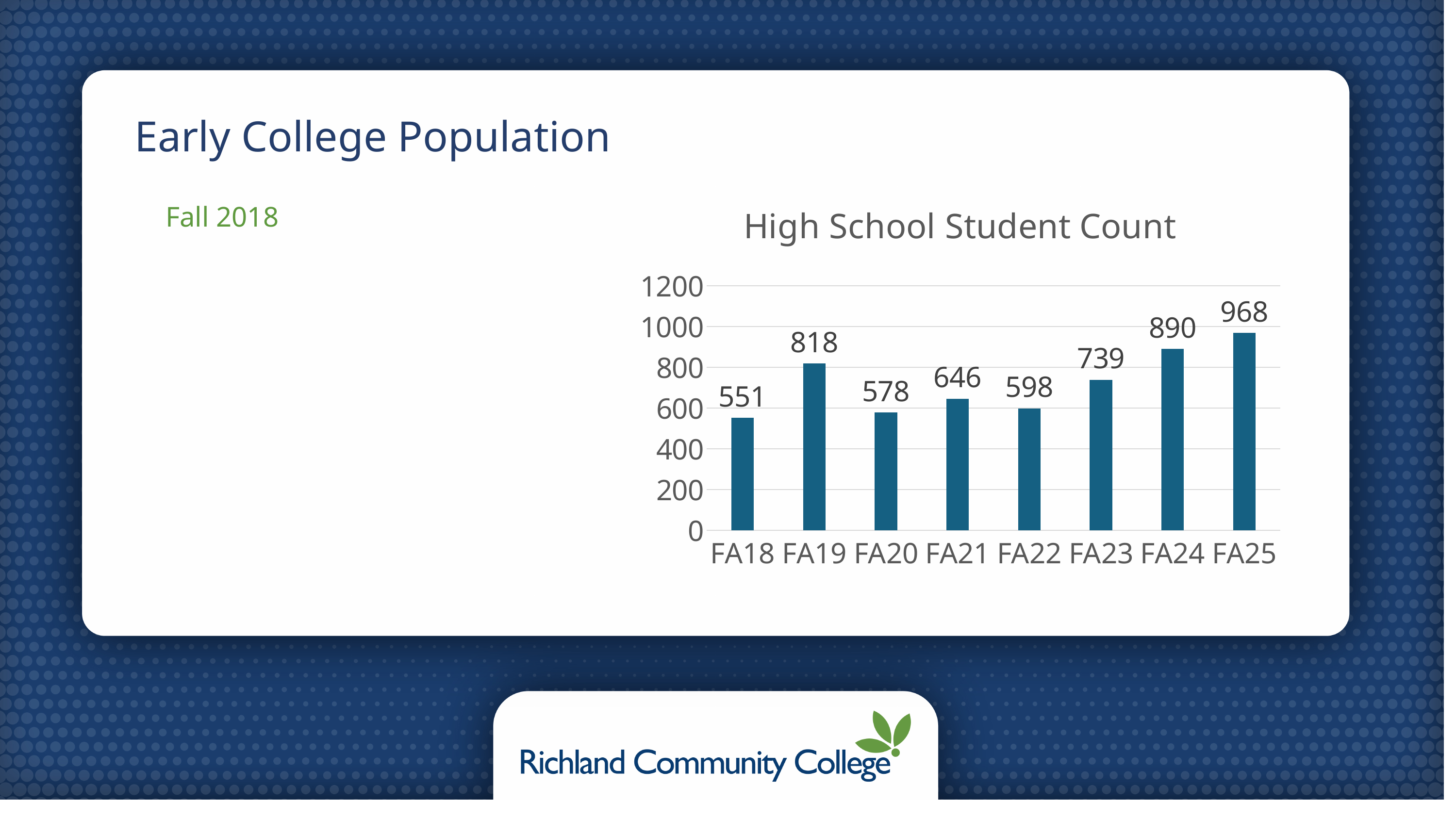
Which term has the lowest High School Student Count? FA18 Is the High School Student Count for FA23 greater or less than 800? less How many terms are shown on the High School Student Count chart? 8 What is the High School Student Count for FA18? 551 Which has a larger High School Student Count, FA21 or FA22? FA21 What is the High School Student Count for FA24? 890 What is the title of the chart on the slide? High School Student Count What kind of chart is used to show the High School Student Count? bar chart Which term has the highest High School Student Count? FA25 What is the difference between the High School Student Count for FA25 and FA18? 417 What is the difference between the High School Student Count for FA19 and FA20? 240 What is the High School Student Count for FA22? 598